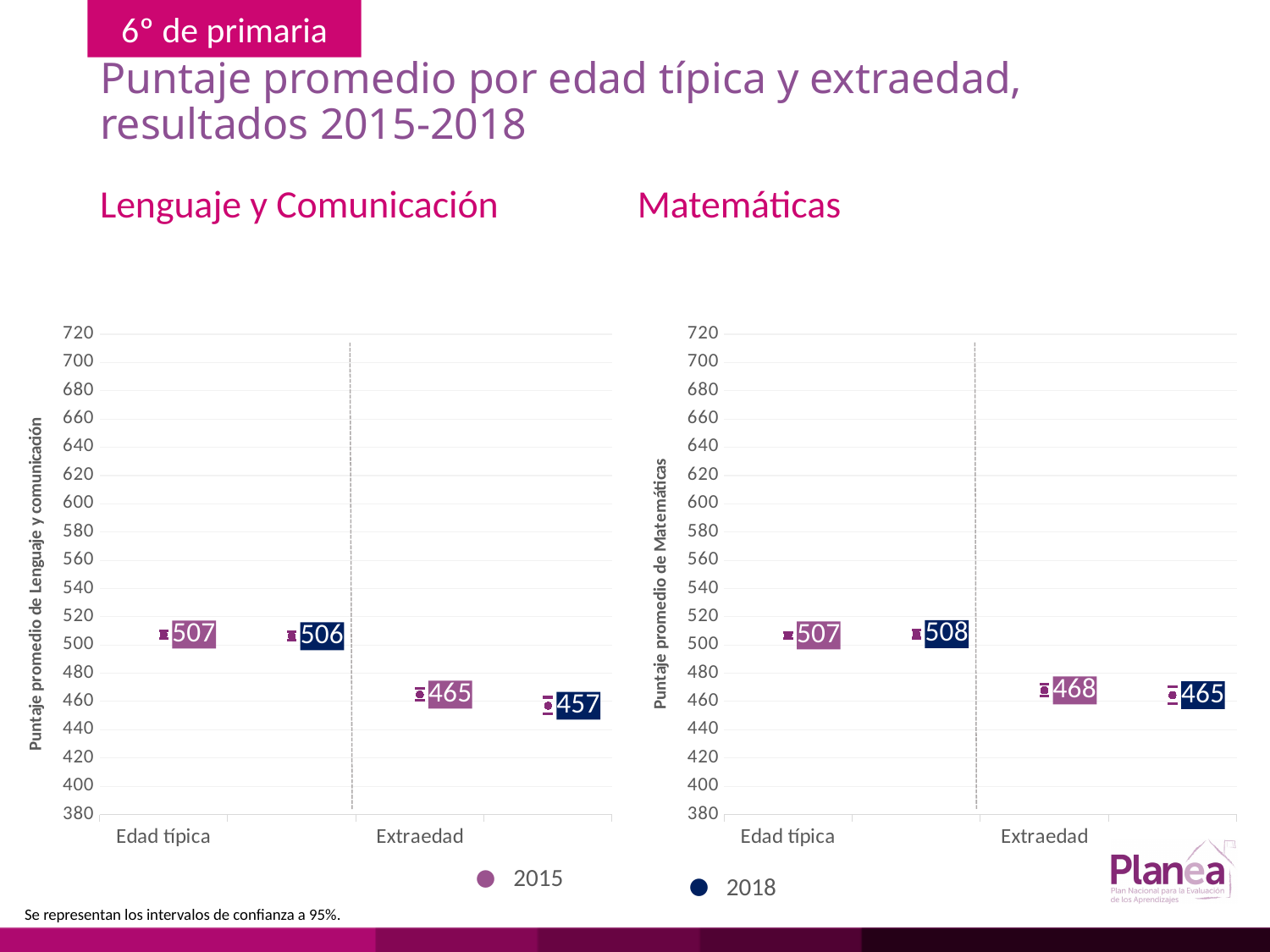
How many categories are shown on the x axis of the Lenguaje y Comunicación chart? 2 In the Lenguaje y Comunicación chart, which category has the lowest 2018 value? Extraedad In the Lenguaje y Comunicación chart, what is the difference between the 2015 and 2018 values for Extraedad? 8 What is the y-axis title of the Matemáticas chart? Puntaje promedio de Matemáticas In the Matemáticas chart, which category has the highest 2015 value? Edad típica In the Matemáticas chart, what is the 2015 value for Extraedad? 468 In the Matemáticas chart, what is the 2018 value for Edad típica? 508 In the Lenguaje y Comunicación chart, what is the 2018 value for Extraedad? 457 In the Matemáticas chart, is the 2015 value for Extraedad greater or less than 500? less In the Matemáticas chart, what is the difference between the Edad típica and Extraedad values for 2018? 43 In the Lenguaje y Comunicación chart, what is the 2015 value for Edad típica? 507 How many series does the legend list for the charts? 2